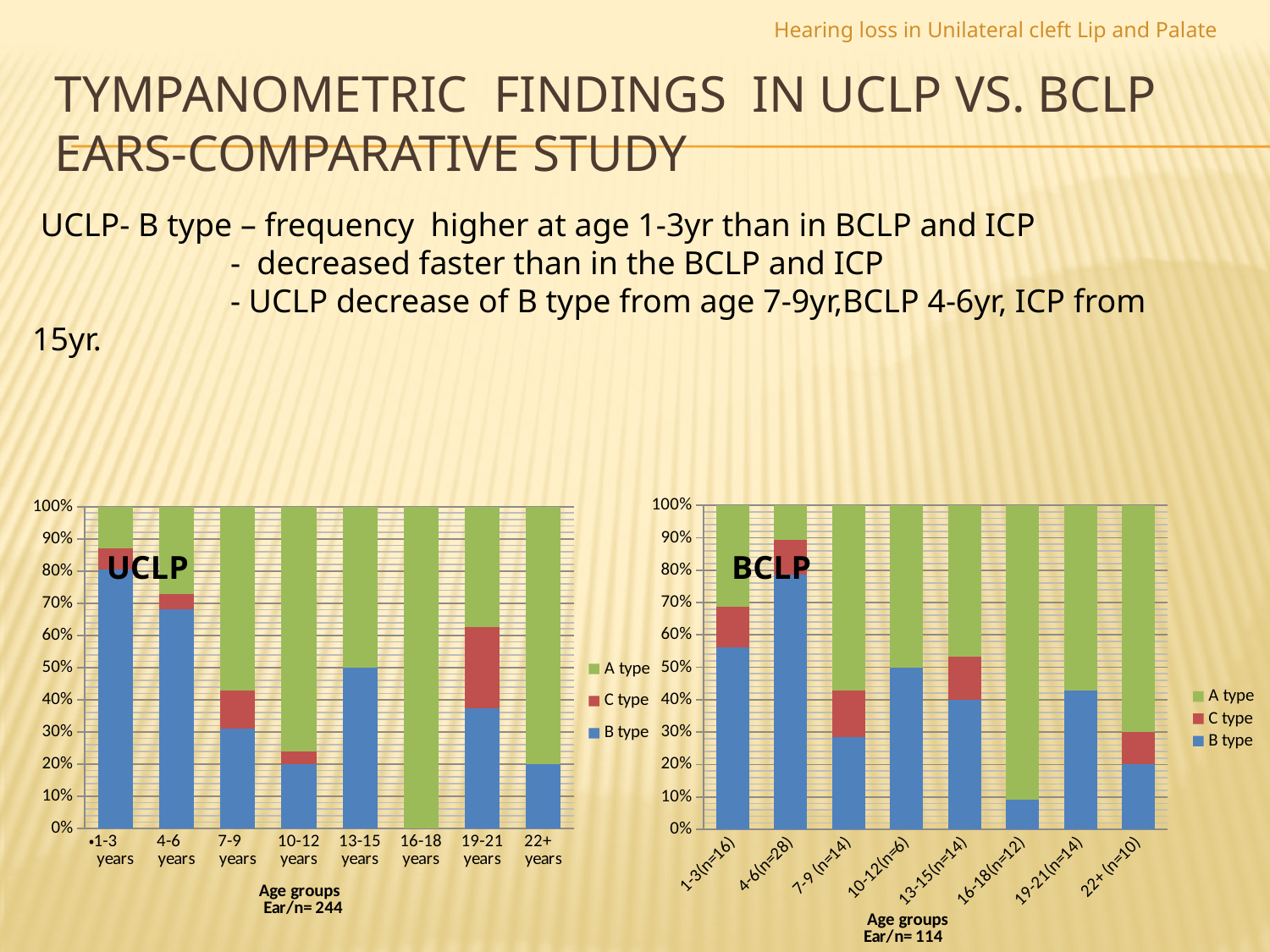
What kind of chart is the UCLP chart on the left? stacked bar chart In the UCLP chart, what is the total of the stacked bar for 16-18 years? 100% In the BCLP chart, is the B type value for 1-3(n=16) greater or less than 50%? greater In the UCLP chart, is the B type value for 19-21 years greater or less than 40%? less In the BCLP chart, which age group has the highest B type share? 4-6(n=28) In the BCLP chart, which age group has the lowest B type share? 16-18(n=12) How many series does the legend of the BCLP chart list? 3 How many age groups are shown on the x axis of the UCLP chart? 8 What is the x-axis label of the BCLP chart? Age groups Ear/n= 114 In the UCLP chart, which age group has the highest B type share? 1-3 years In the UCLP chart, which age group has the lowest B type share? 16-18 years In the UCLP chart, what is the B type value for 13-15 years? 50%